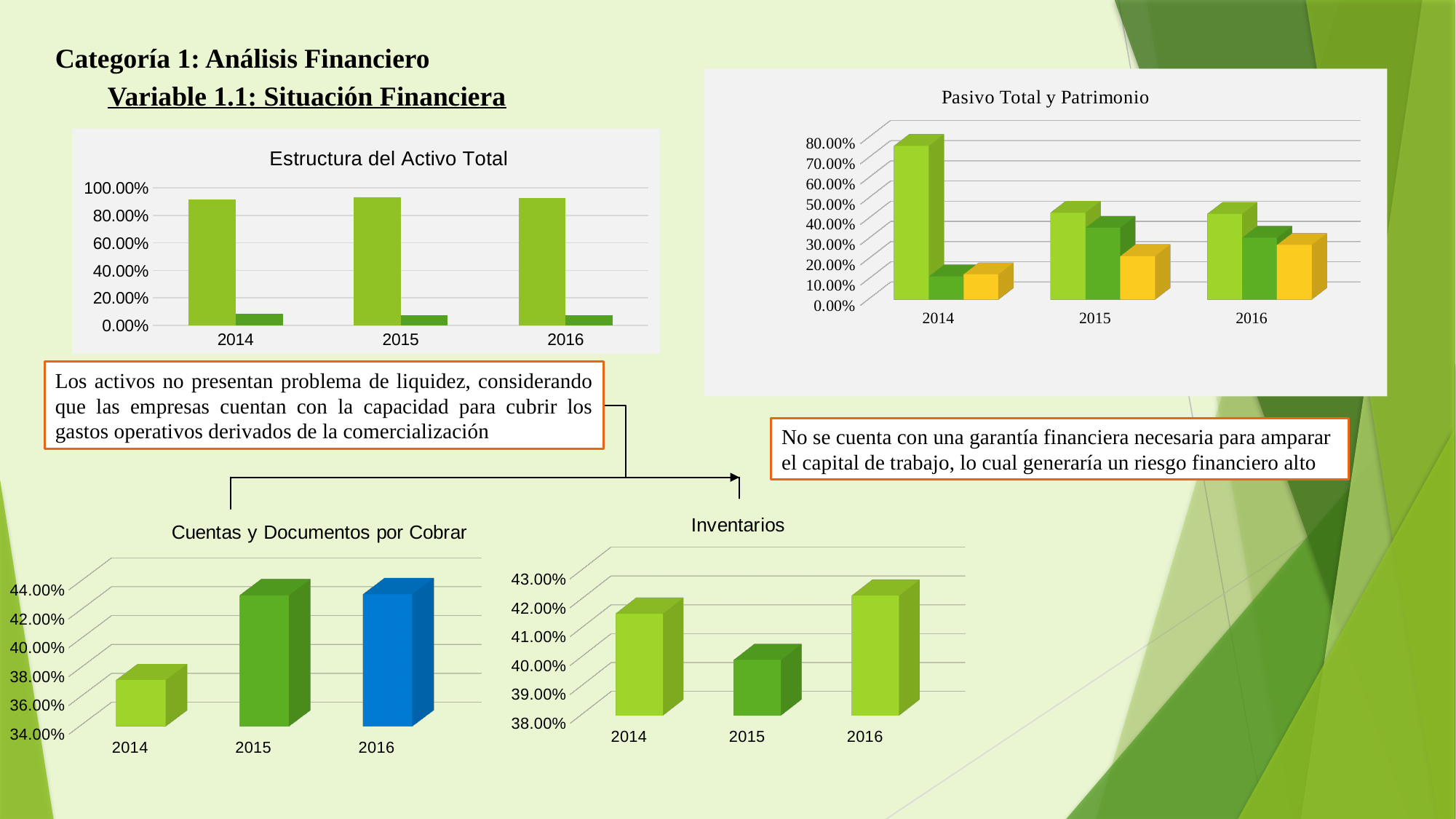
In the "Estructura del Activo Total" chart, how many years are shown on the x axis? 3 In the "Pasivo Total y Patrimonio" chart, do the yellow bars rise or fall from 2014 to 2016? rise In the "Pasivo Total y Patrimonio" chart, is the value of the light green bar for 2014 greater or less than 70.00%? greater What kind of chart is "Estructura del Activo Total"? bar chart In the "Estructura del Activo Total" chart, is the value of the shorter (dark green) bar for 2016 greater or less than 20.00%? less In the "Estructura del Activo Total" chart, is the value of the taller (light green) bar for 2014 greater or less than 80.00%? greater In the "Cuentas y Documentos por Cobrar" chart, which year has the lowest value? 2014 In the "Pasivo Total y Patrimonio" chart, in which year is the light green bar highest? 2014 In the "Inventarios" chart, which year has the lowest value? 2015 In the "Inventarios" chart, which is larger, the value for 2014 or the value for 2015? 2014